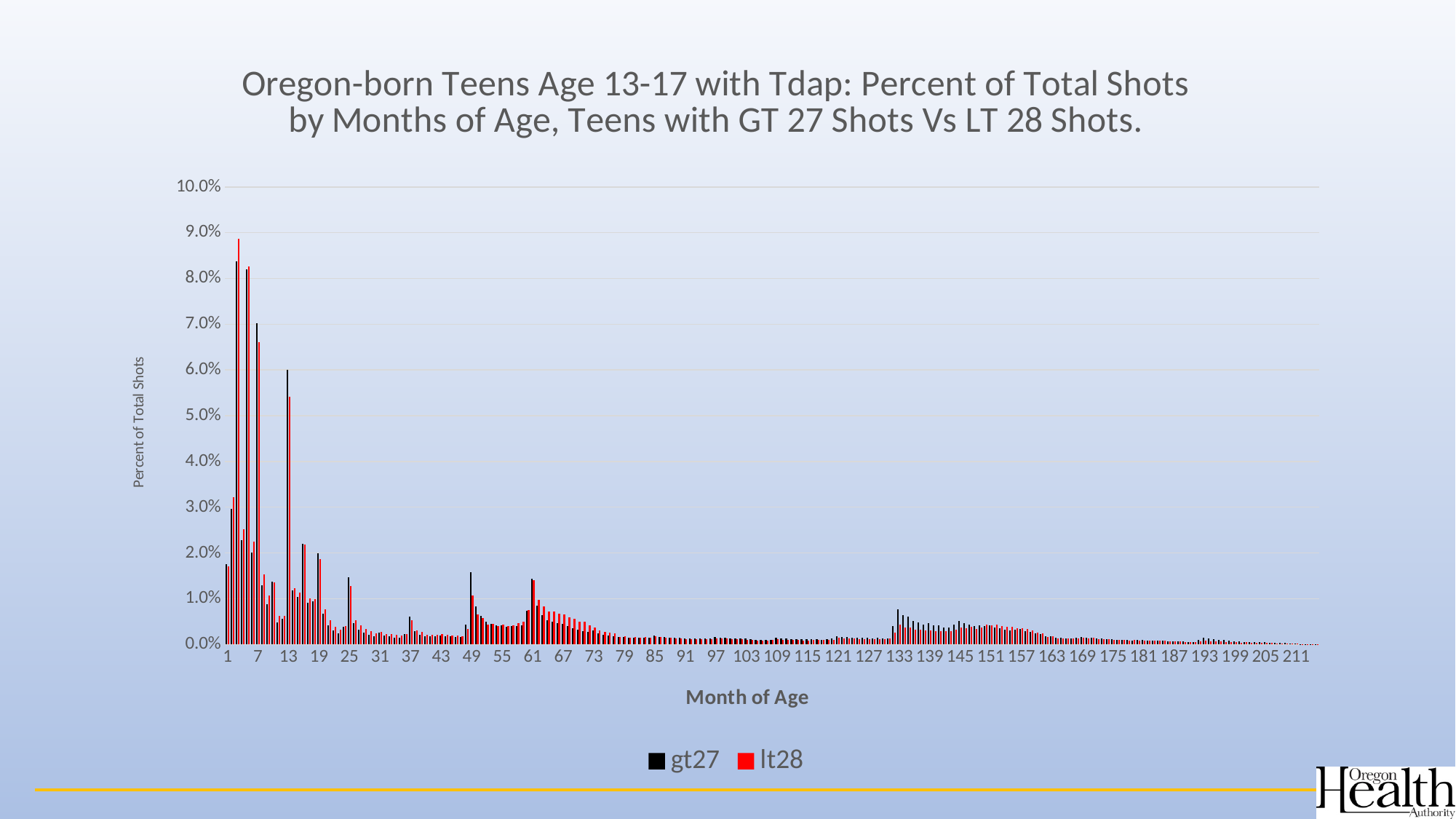
Which series reaches the higher peak value, gt27 or lt28? lt28 What are the two series named in the legend? gt27 and lt28 What is the last month label shown on the x axis? 211 What is the maximum value shown on the y axis? 10.0% How many series does the legend list? 2 Is the highest lt28 value greater or less than 8.0%? greater What kind of chart is shown on the slide? bar chart Is the highest gt27 value greater or less than 9.0%? less Are the values for months 85 through 127 greater or less than 1.0%? less Do the values generally rise or fall as month of age increases along the x axis? fall